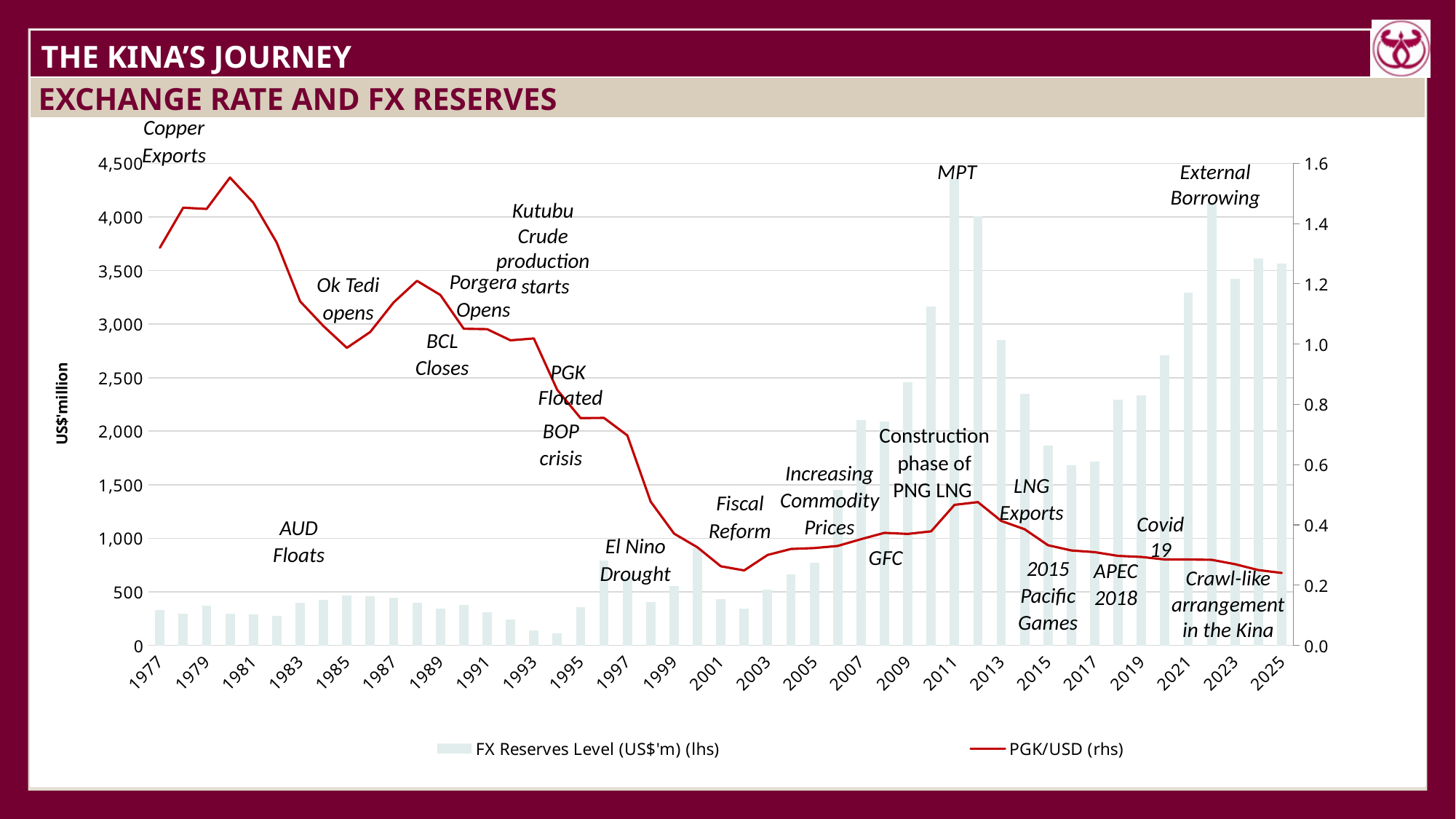
What is the label on the left vertical axis of the chart? US$'million How many series does the chart's legend list? 2 What kind of chart is shown on the slide? Combined bar and line chart Is the FX Reserves Level for 2011 greater or less than 4,000? greater Does the PGK/USD line generally rise or fall from 1977 to 2025? fall Is the PGK/USD value for 2025 greater or less than 0.4? less Which series is plotted as bars in the chart? FX Reserves Level (US$'m) (lhs) In which year is the FX Reserves Level bar the highest? 2011 In which year does the PGK/USD line reach its highest value? 1980 Is the FX Reserves Level for 2010 greater or less than 3,000? greater